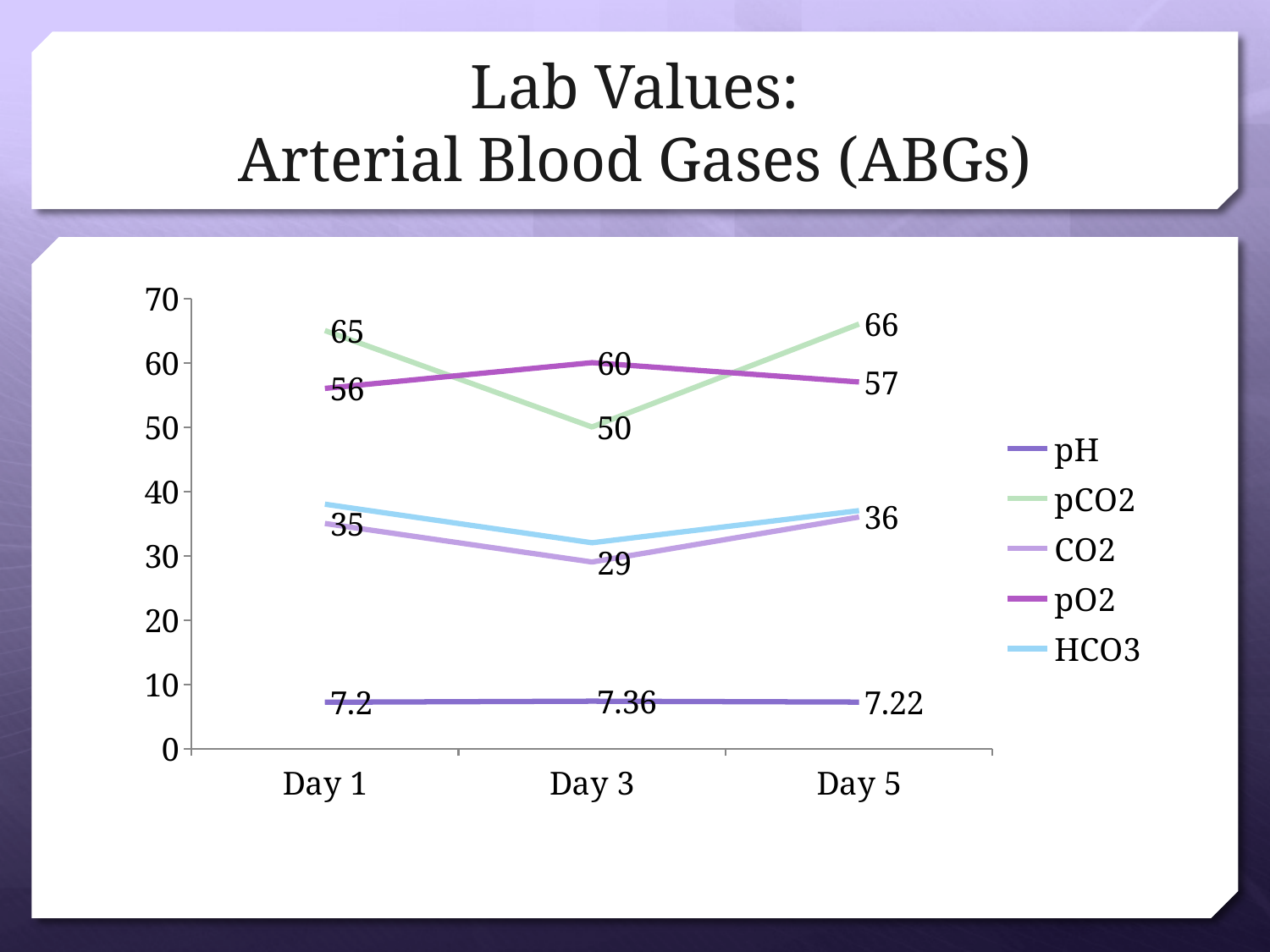
What is the pCO2 value on Day 3? 50 On which day is the CO2 value lowest? Day 3 What kind of chart is shown on the slide? line chart What is the difference between the pCO2 values on Day 1 and Day 3? 15 On Day 3, which is larger, pO2 or pCO2? pO2 How many series does the legend list? 5 On which day is the pO2 value highest? Day 3 Is the HCO3 value on Day 1 greater or less than 40? less What is the pH value on Day 3? 7.36 Does the pCO2 value rise or fall from Day 1 to Day 3? fall What is the pO2 value on Day 5? 57 How many days are plotted along the x axis? 3